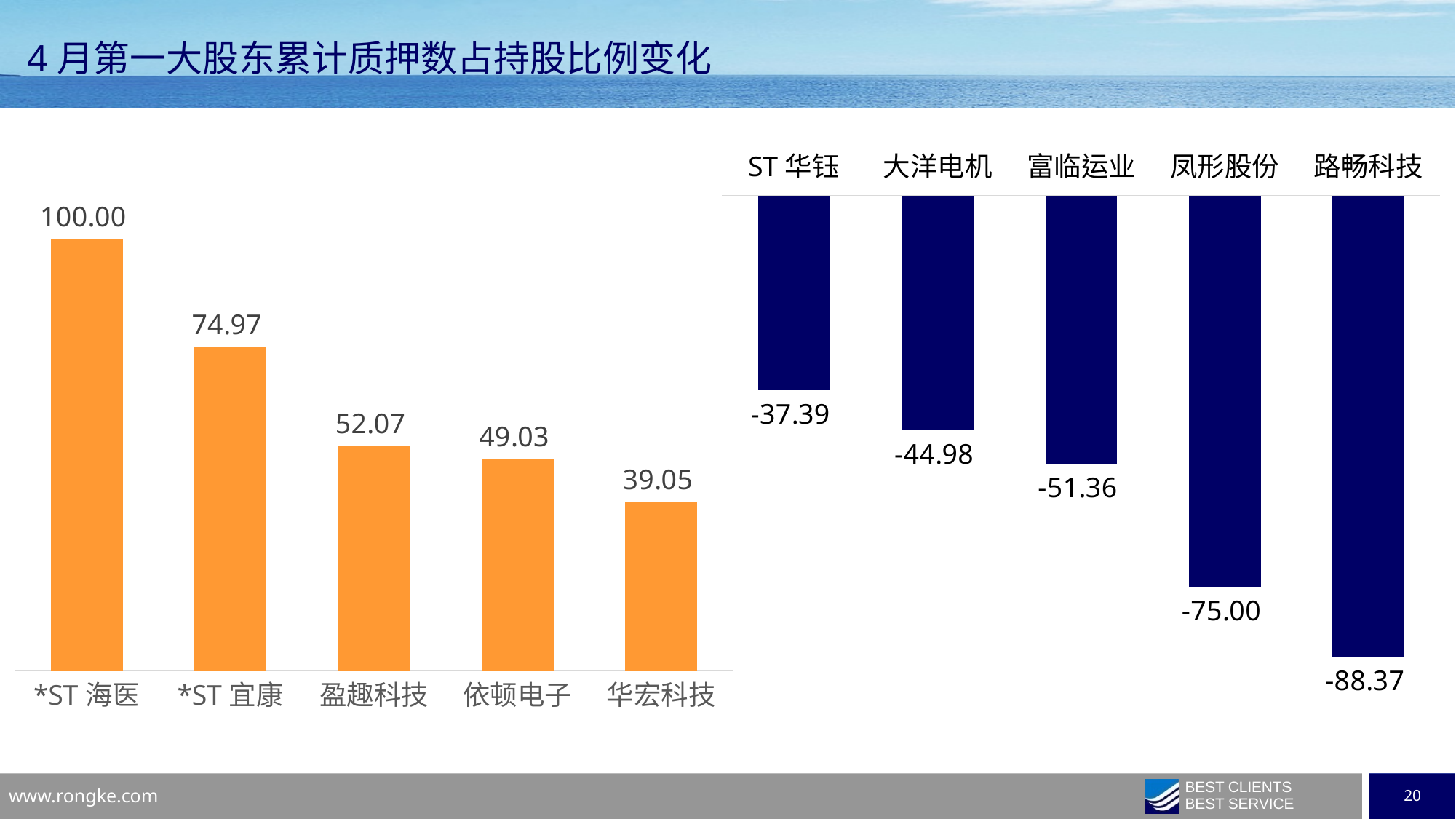
In the left chart (orange bars), what is the difference between the values for *ST 海医 and *ST 宜康? 25.03 In the right chart (dark blue bars), which category has the lowest value? 路畅科技 How many categories are shown in the right chart (dark blue bars)? 5 In the right chart (dark blue bars), which category has the highest value? ST 华钰 In the left chart (orange bars), what is the value for 盈趣科技? 52.07 In the right chart (dark blue bars), what is the value for 路畅科技? -88.37 In the left chart (orange bars), which is larger, the value for 依顿电子 or the value for 华宏科技? 依顿电子 In the left chart (orange bars), what is the value for *ST 海医? 100.00 In the right chart (dark blue bars), what is the difference between the values for 凤形股份 and 大洋电机? 30.02 In the left chart (orange bars), which category has the lowest value? 华宏科技 What kind of chart is the left chart (orange bars)? Bar chart In the right chart (dark blue bars), what is the value for 富临运业? -51.36